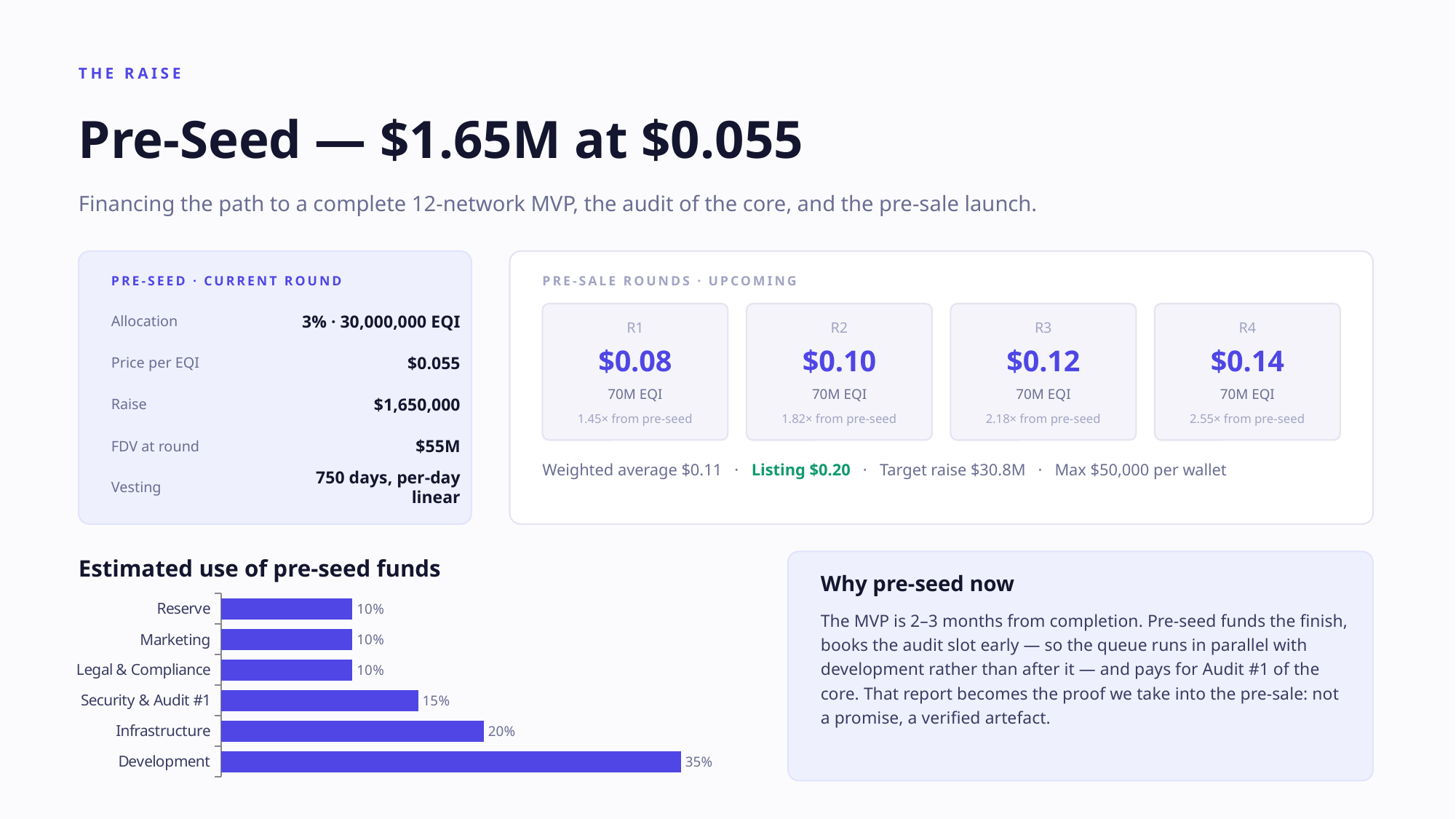
Which category receives the largest share of pre-seed funds? Development What is the difference between the Infrastructure and Security & Audit #1 shares? 5% What share of pre-seed funds is allocated to Development? 35% What is the difference between the Development and Infrastructure shares of pre-seed funds? 15% What is the title of the chart on the slide? Estimated use of pre-seed funds Which is larger, the share for Infrastructure or the share for Security & Audit #1? Infrastructure What share of pre-seed funds is allocated to Marketing? 10% What share of pre-seed funds is allocated to Infrastructure? 20% What kind of chart is used to show the estimated use of pre-seed funds? Bar chart What share of pre-seed funds is allocated to Security & Audit #1? 15% How many categories are shown in the 'Estimated use of pre-seed funds' chart? 6 How many categories in the chart each receive 10% of pre-seed funds? 3